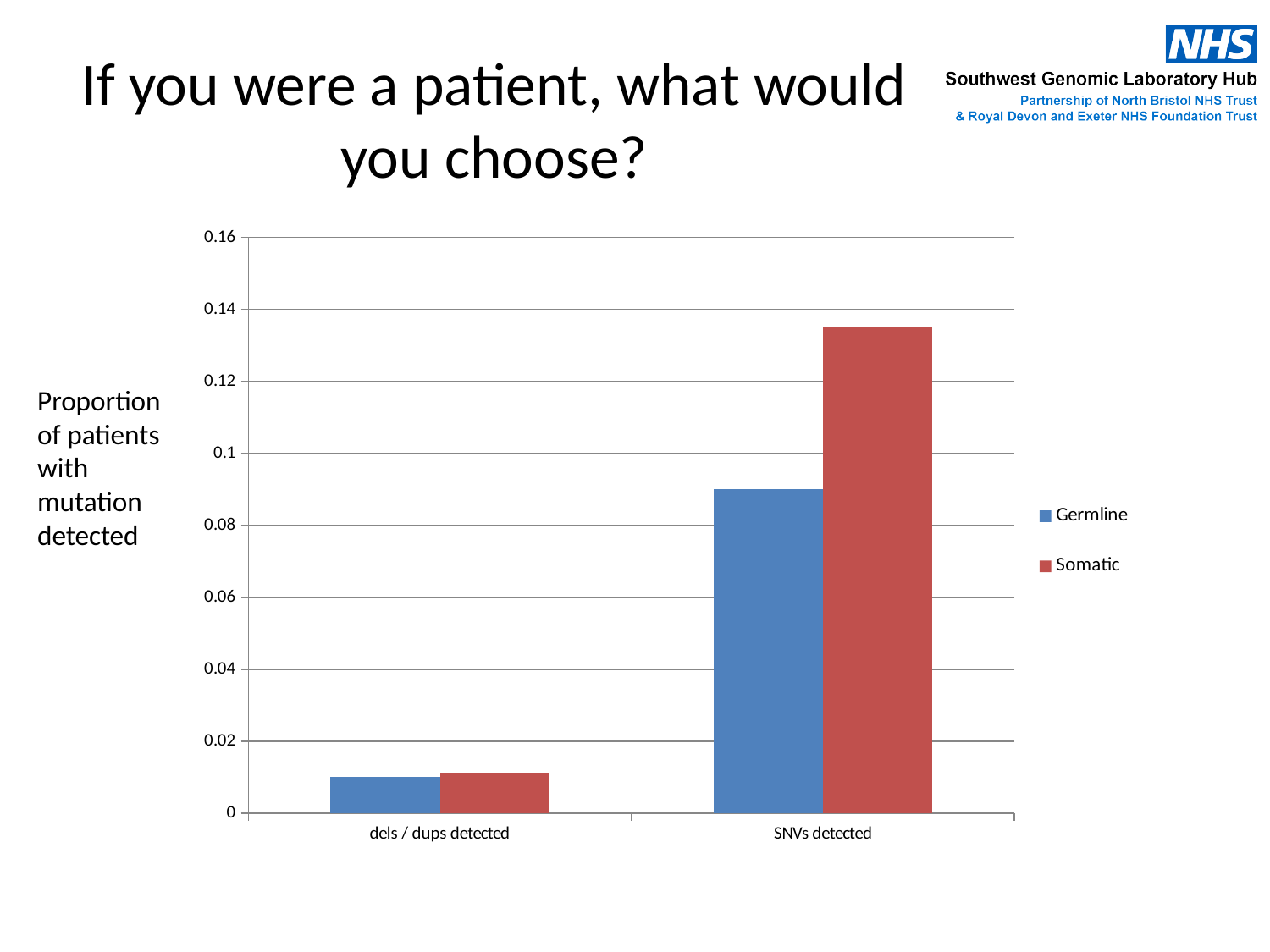
Which series and category has the highest bar? Somatic, SNVs detected Is the Germline value for SNVs detected greater or less than 0.1? less Is the Germline value for dels / dups detected greater or less than 0.02? less What kind of chart is shown on the slide? bar chart How many series does the legend list? 2 For the Germline series, which is larger: dels / dups detected or SNVs detected? SNVs detected Which category has the lower values for both series? dels / dups detected How many categories are shown on the x axis? 2 Is the Germline value for SNVs detected greater or less than 0.08? greater What colour are the Somatic bars? red For SNVs detected, which is larger: Germline or Somatic? Somatic